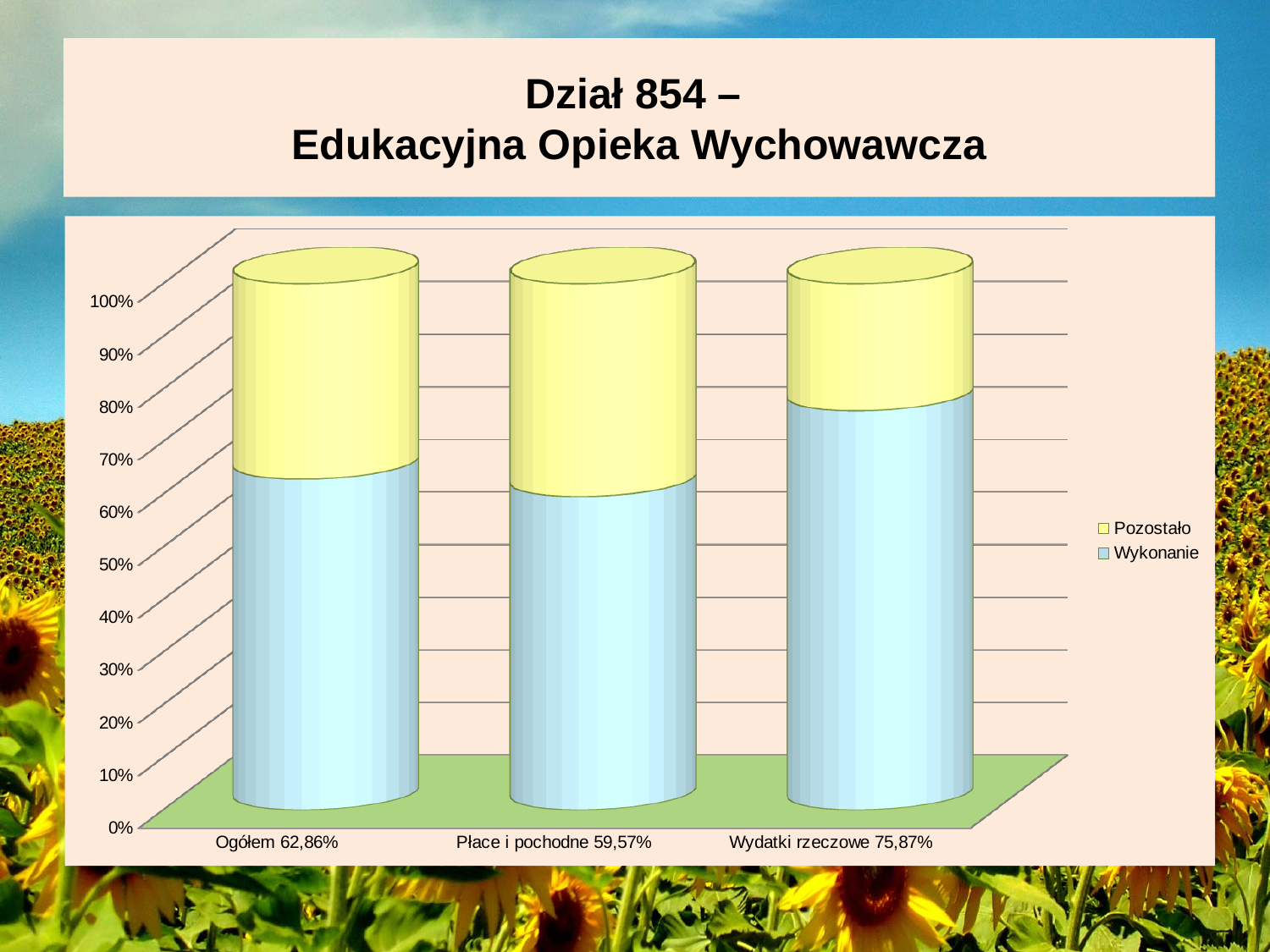
What Wykonanie percentage is shown for Wydatki rzeczowe? 75,87% What is the difference between the Wykonanie percentage for Wydatki rzeczowe and for Płace i pochodne? 16,30% What type of chart is shown on the slide? bar chart What Wykonanie percentage is shown for Płace i pochodne? 59,57% What Wykonanie percentage is shown for Ogółem? 62,86% Which series is shown in yellow in the legend? Pozostało Which category has the highest Wykonanie percentage? Wydatki rzeczowe What is the title of the slide's chart? Dział 854 – Edukacyjna Opieka Wychowawcza Is the Wykonanie value for Wydatki rzeczowe greater or less than 70%? greater Which category has the lowest Wykonanie percentage? Płace i pochodne How many categories are shown on the x axis? 3 How many series does the legend list? 2